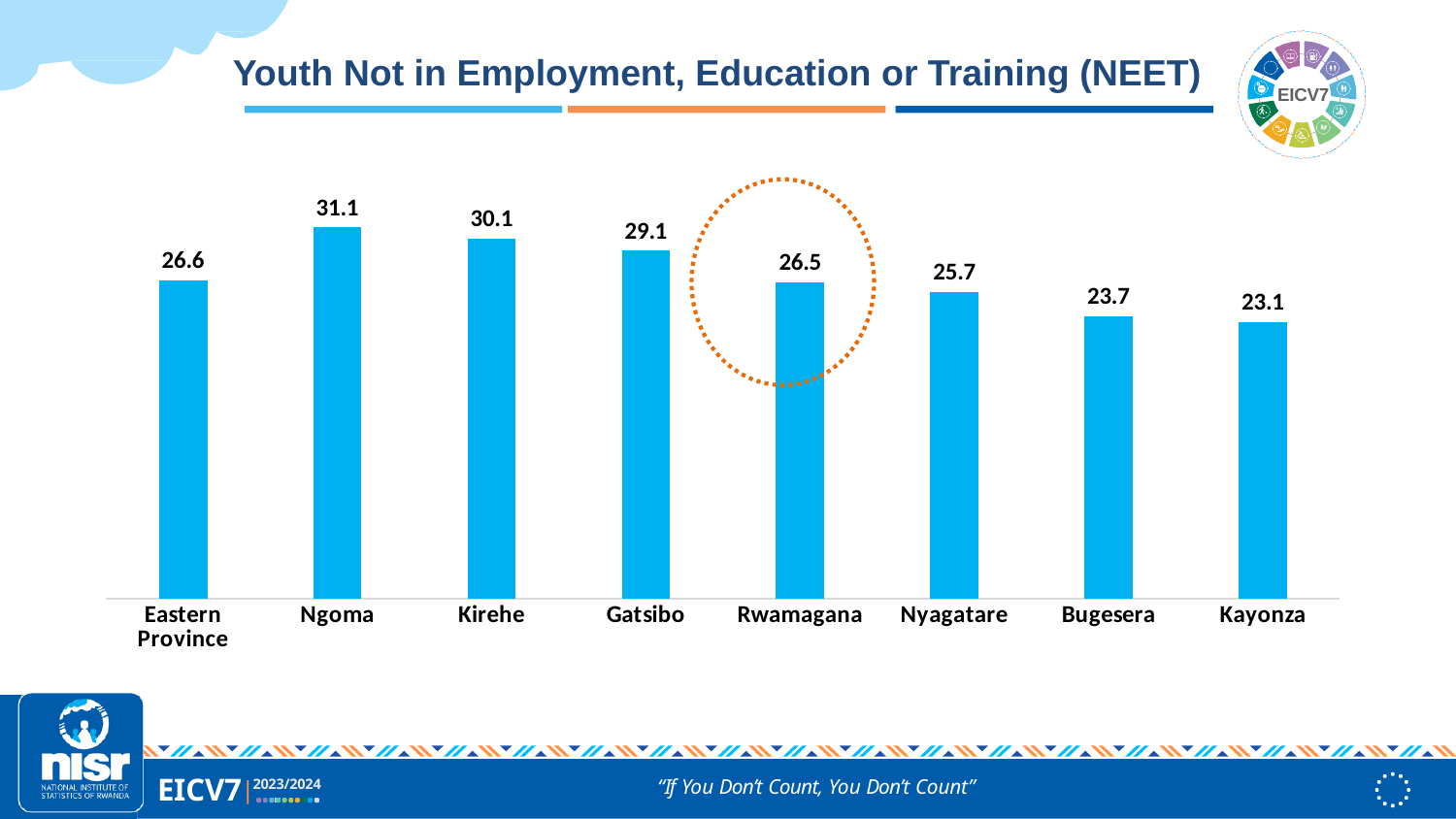
What kind of chart is shown on the slide? Bar chart What is the NEET value for Rwamagana? 26.5 Which category has the highest NEET value? Ngoma What is the difference between the NEET values for Kirehe and Gatsibo? 1.0 What is the difference between the NEET values for Ngoma and Kayonza? 8.0 Do the values rise or fall from Kirehe to Kayonza along the x axis? Fall How many categories are shown on the x axis? 8 Which bar is highlighted with a dotted orange circle? Rwamagana What is the NEET value for Eastern Province? 26.6 Which has a higher NEET value, Nyagatare or Bugesera? Nyagatare Which category has the lowest NEET value? Kayonza What is the NEET value for Ngoma? 31.1